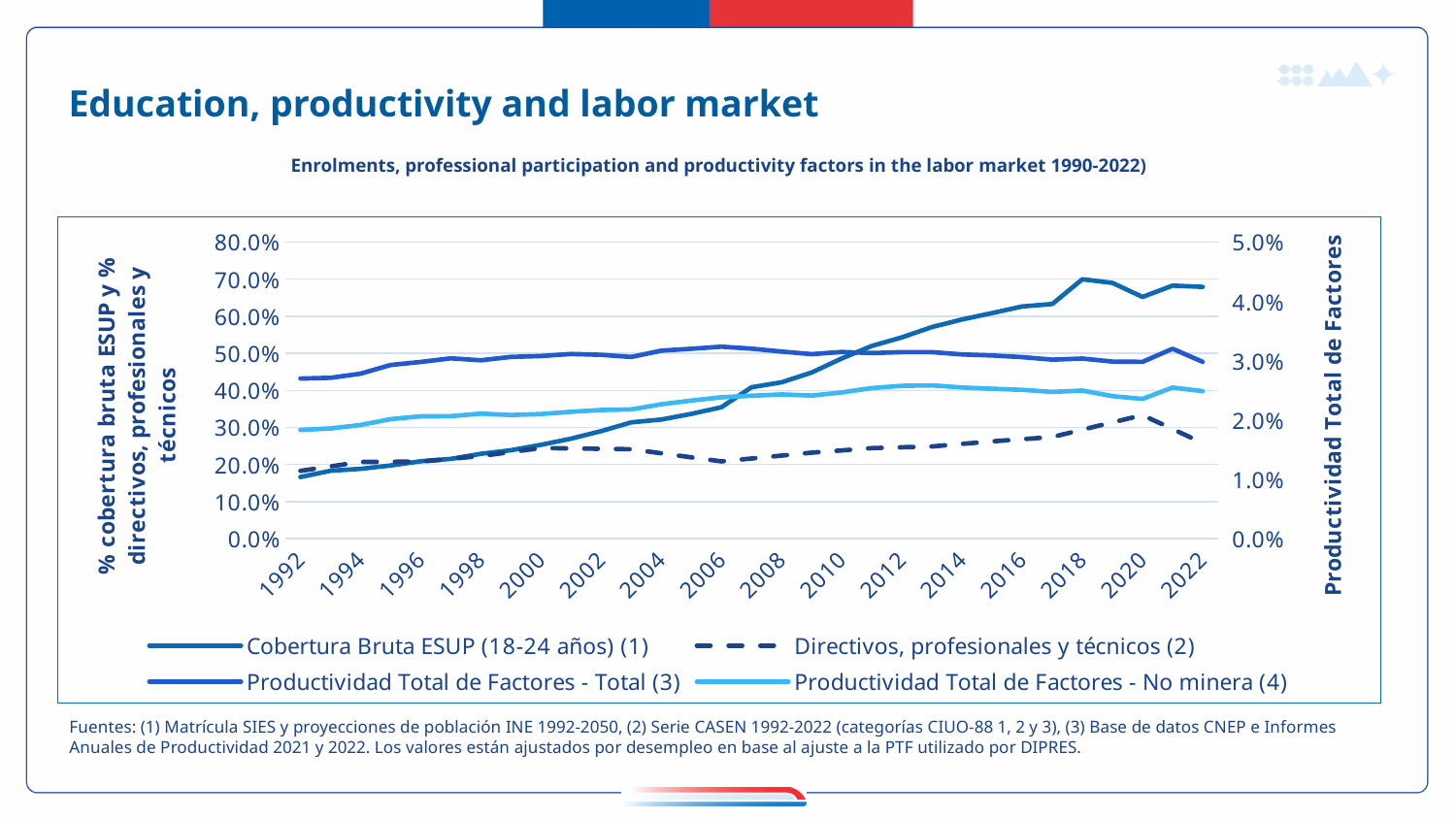
Does the Cobertura Bruta ESUP (18-24 años) (1) line rise or fall from 1992 to 2022? rise What is the title of the right-hand vertical axis? Productividad Total de Factores Is the value for Cobertura Bruta ESUP (18-24 años) (1) in 2022 greater or less than 60.0% on the left axis? greater In 2022, which is higher: Cobertura Bruta ESUP (18-24 años) (1) or Directivos, profesionales y técnicos (2)? Cobertura Bruta ESUP (18-24 años) (1) What is the maximum value shown on the left vertical axis? 80.0% How many year labels are shown on the x axis? 16 Is the value for Directivos, profesionales y técnicos (2) in 2022 greater or less than 30.0% on the left axis? less How many series does the legend list? 4 Which series reaches the highest point on the chart in 2022? Cobertura Bruta ESUP (18-24 años) (1) Is the value for Cobertura Bruta ESUP (18-24 años) (1) in 1992 greater or less than 20.0% on the left axis? less Which series is drawn with a dashed line? Directivos, profesionales y técnicos (2) What kind of chart is shown on the slide? line chart